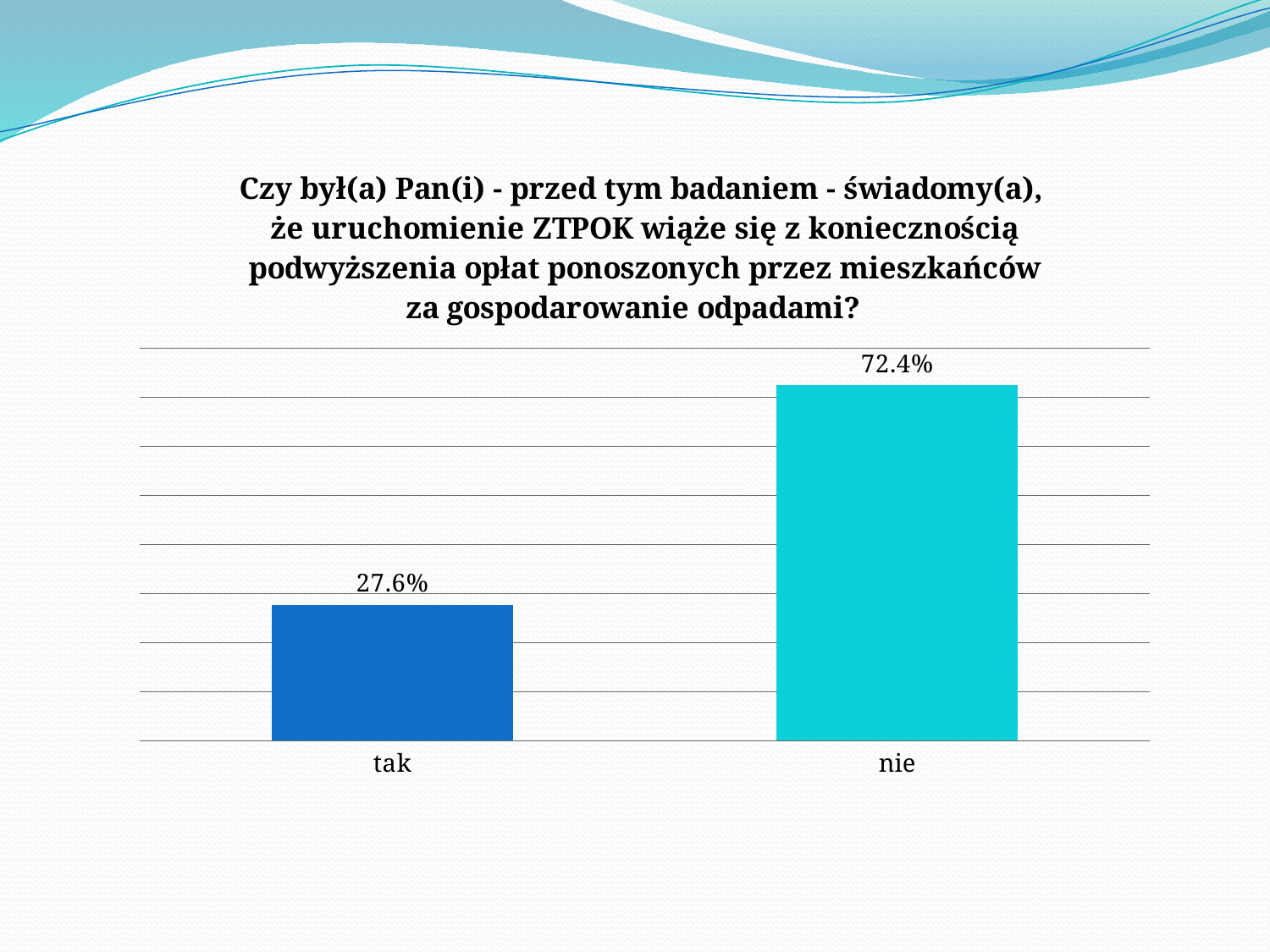
What colour is the bar for "tak"? dark blue What kind of chart is shown on the slide? bar chart What is the value for "nie"? 72.4% Which category has the lowest value? tak Which is larger, the value for "tak" or the value for "nie"? nie What is the value for "tak"? 27.6% What colour is the bar for "nie"? turquoise What is the difference between the values for "nie" and "tak"? 44.8% What is the total of the two values shown on the chart? 100% Which category has the highest value? nie How many categories are shown on the chart? 2